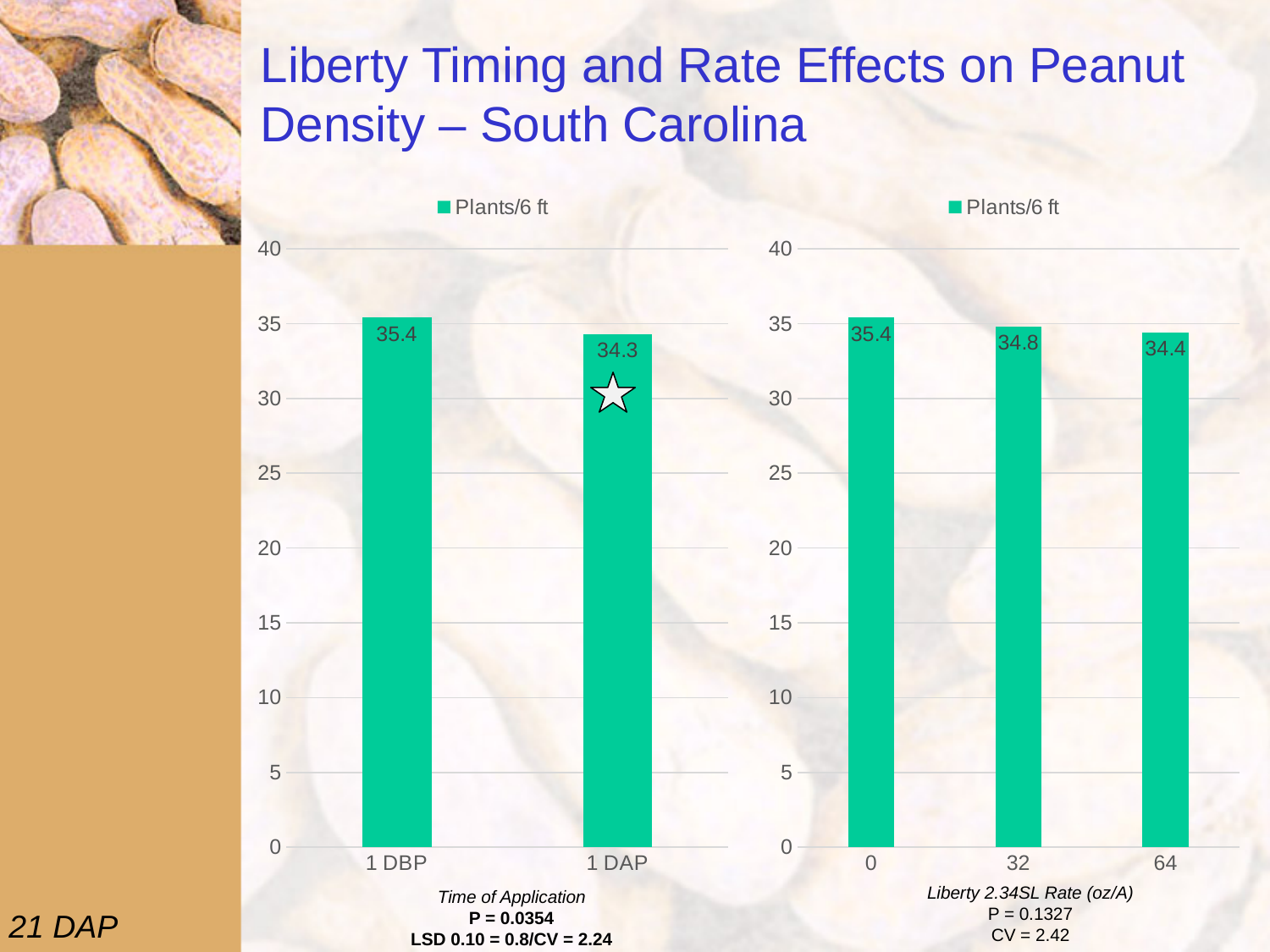
In the left chart (Time of Application), which is larger, the value for 1 DBP or 1 DAP? 1 DBP In the left chart (Time of Application), what is the value for 1 DBP? 35.4 In the right chart (Liberty 2.34SL Rate), what is the difference between the values for 0 and 64 oz/A? 1.0 In the right chart (Liberty 2.34SL Rate), which rate has the highest value? 0 In the right chart (Liberty 2.34SL Rate), what is the value for the 64 oz/A rate? 34.4 What kind of chart is the left chart (Time of Application)? bar chart In the right chart (Liberty 2.34SL Rate), what is the value for the 32 oz/A rate? 34.8 In the left chart (Time of Application), what is the difference between the values for 1 DBP and 1 DAP? 1.1 In the left chart (Time of Application), what is the value for 1 DAP? 34.3 In the right chart (Liberty 2.34SL Rate), which rate has the lowest value? 64 In the right chart (Liberty 2.34SL Rate), do the values rise or fall as the rate increases along the x axis? fall How many categories are shown on the x axis of the right chart (Liberty 2.34SL Rate)? 3